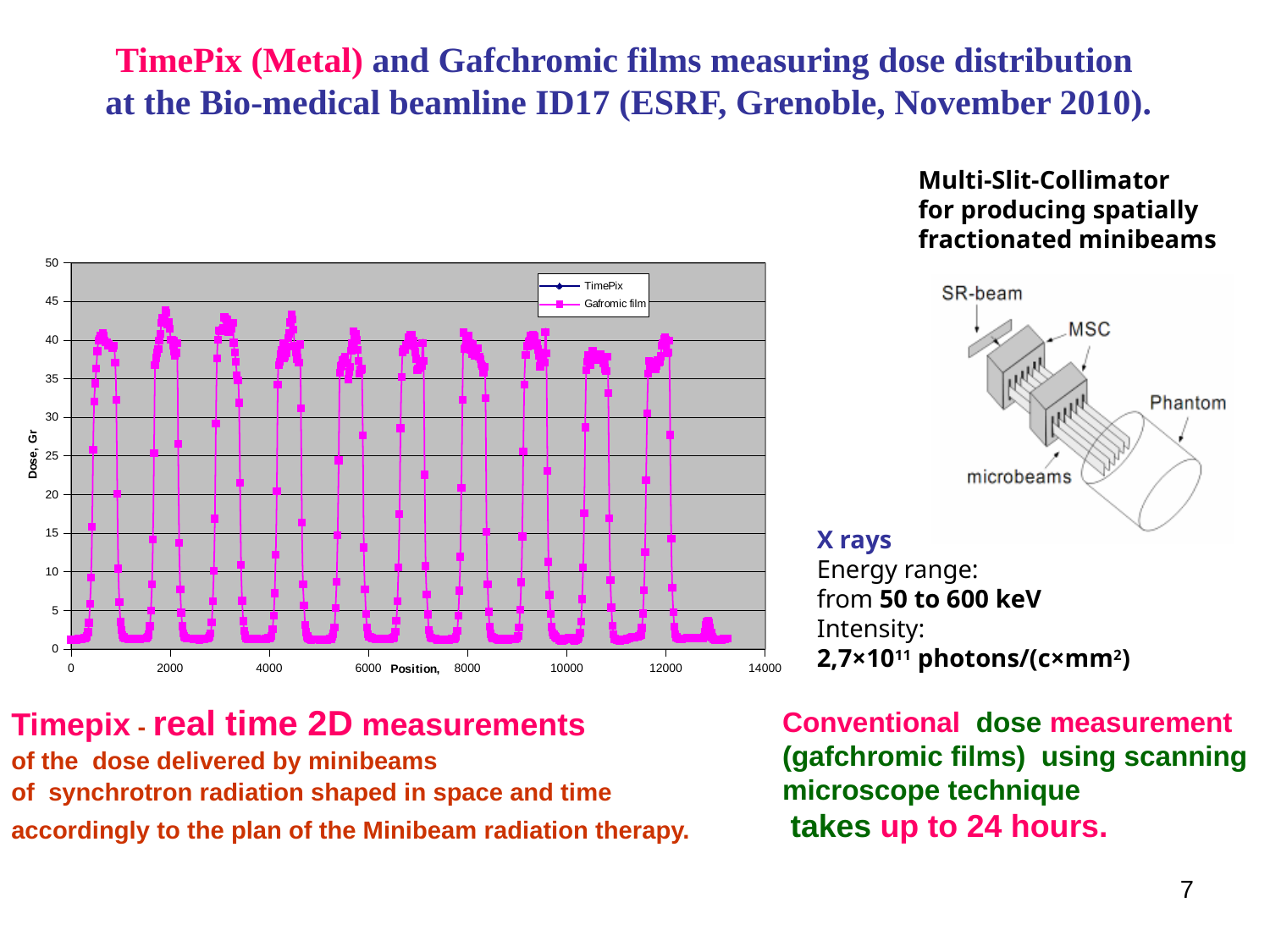
What kind of chart is shown on the slide? line chart What are the two series named in the chart legend? TimePix and Gafromic film Is the highest dose value plotted on the chart greater or less than 35? greater Is the lowest dose value plotted on the chart (between the peaks) greater or less than 5? less Is the highest dose value plotted on the chart greater or less than 50? less How many series does the chart legend list? 2 What is the label of the vertical axis of the chart? Dose, Gr